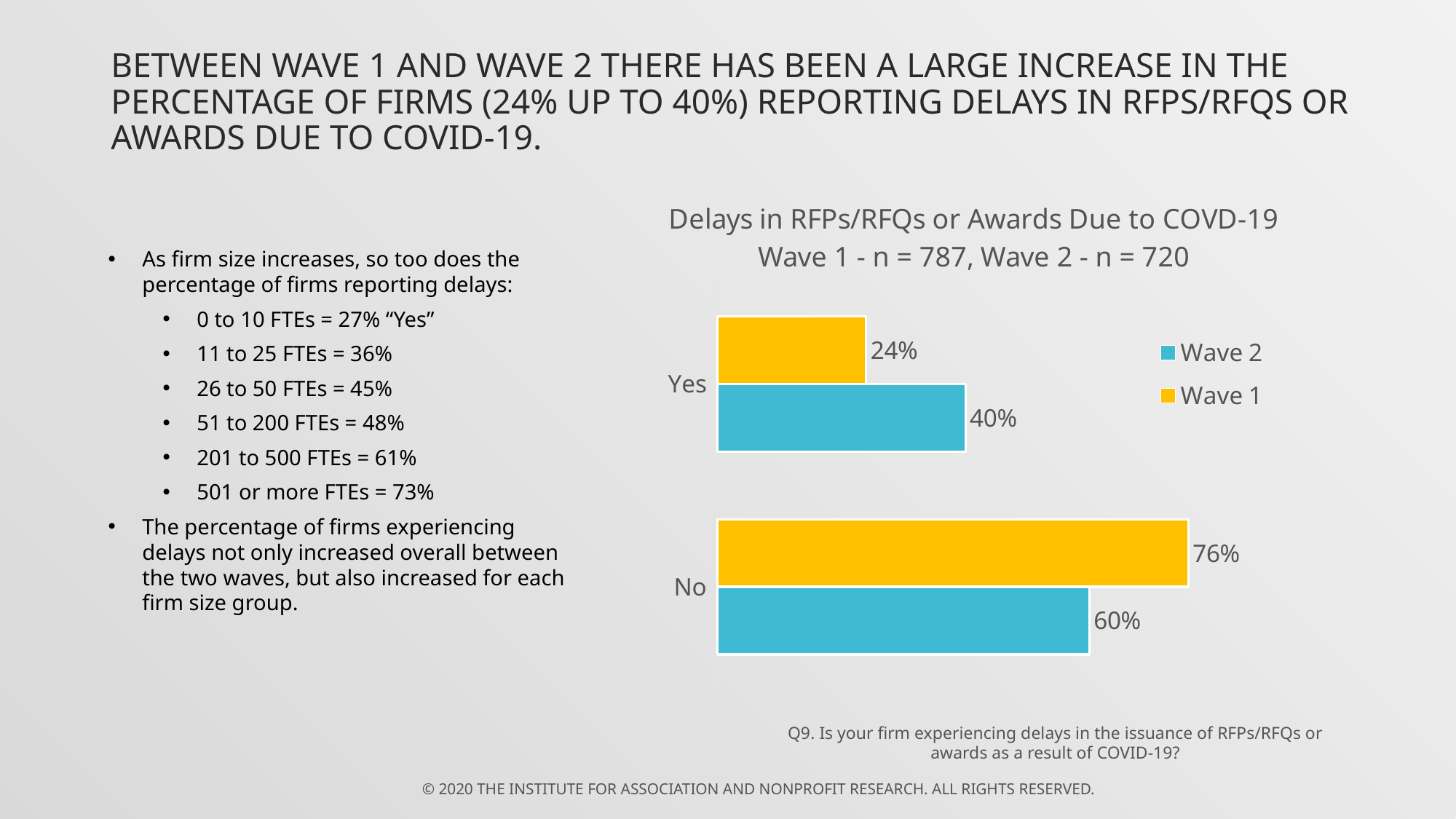
What is the difference between the Wave 2 and Wave 1 values for "Yes"? 16 percentage points What percentage of firms answered "No" in Wave 2? 60% What type of chart is shown on the slide? Bar chart Which is larger: the Wave 1 value for "No" or the Wave 2 value for "No"? Wave 1 How many series does the chart legend list? 2 Which response category has the lowest value for Wave 2? Yes What is the difference between the Wave 1 and Wave 2 values for "No"? 16 percentage points What is the title of the chart? Delays in RFPs/RFQs or Awards Due to COVD-19 Wave 1 - n = 787, Wave 2 - n = 720 Which response category has the highest value for Wave 1? No What percentage of firms answered "No" in Wave 1? 76% What percentage of firms answered "Yes" in Wave 2? 40% What percentage of firms answered "Yes" in Wave 1? 24%